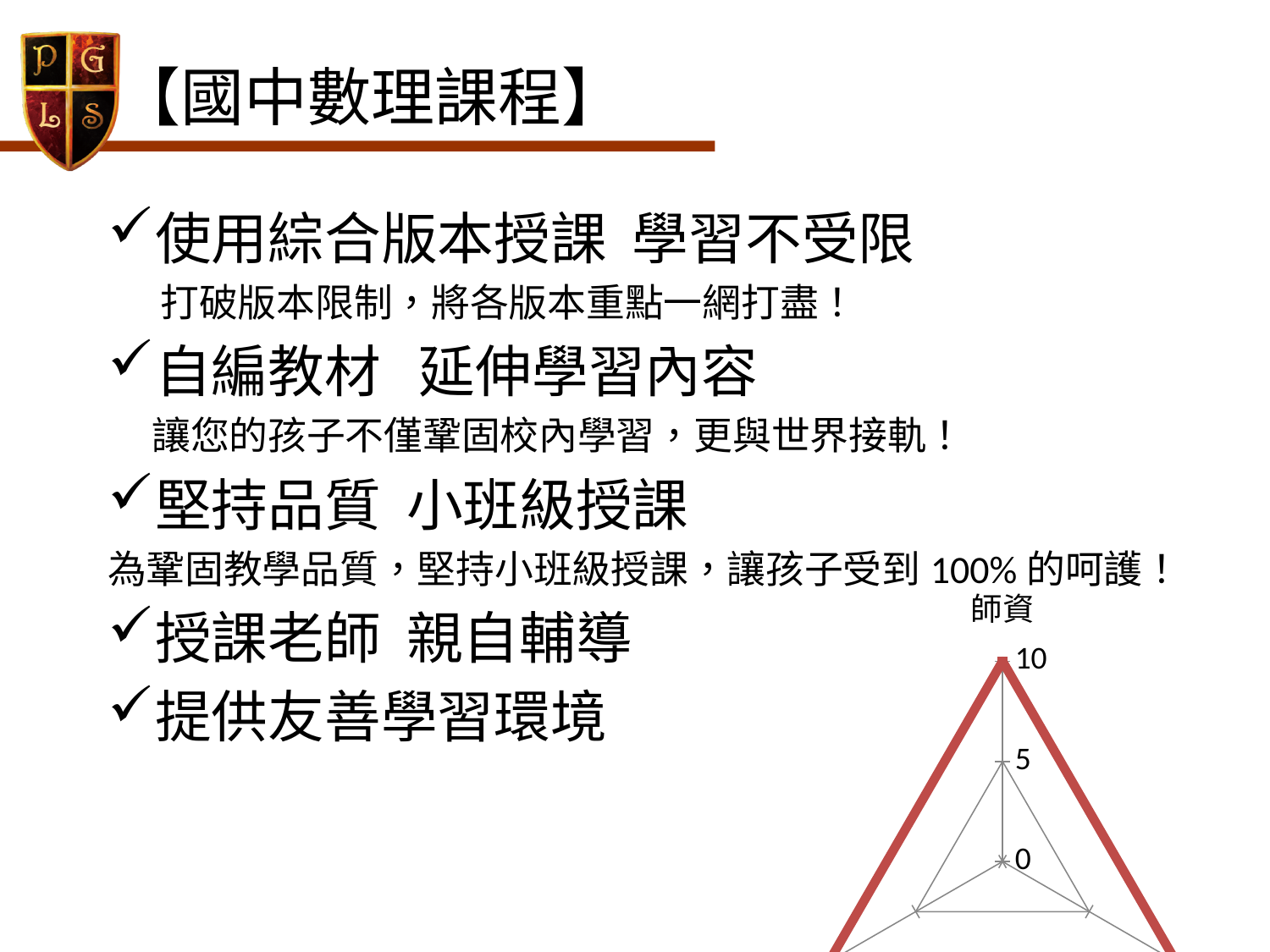
What is the highest tick value shown on the radar chart's axis? 10 What is the value for 師資 on the radar chart? 10 What colour is the data line on the radar chart? red What kind of chart is shown at the bottom right of the slide? radar chart Is the value for 師資 on the radar chart greater or less than 5? greater How many axes (categories) does the radar chart have? 3